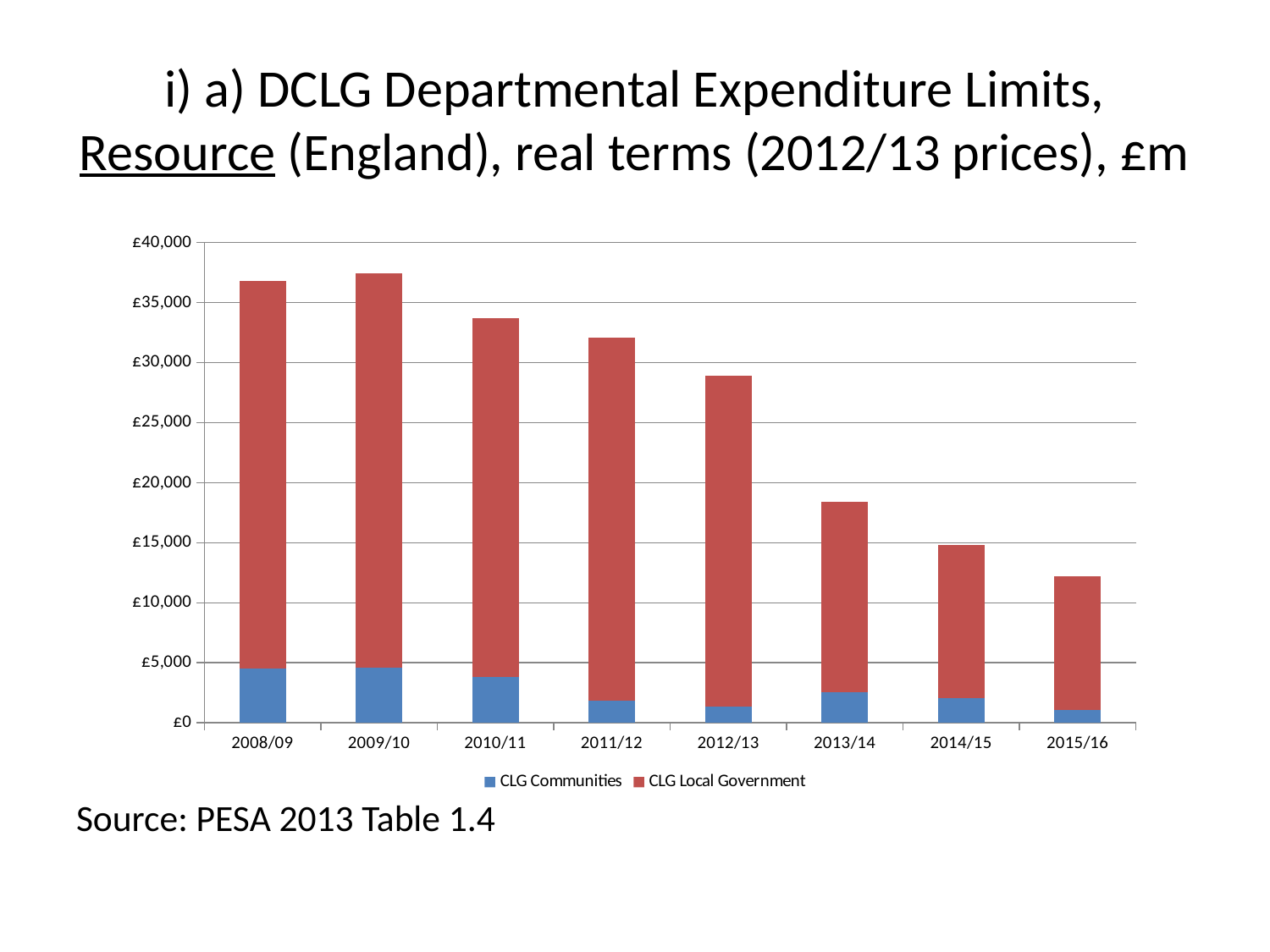
Is the total bar for 2012/13 greater or less than £25,000? greater Do the total bar heights generally rise or fall from 2009/10 to 2015/16? Fall Which series is shown in red in the chart? CLG Local Government Is the total bar for 2013/14 greater or less than £20,000? less How many years are shown on the x axis of the chart? 8 What source is cited below the chart? PESA 2013 Table 1.4 What kind of chart is shown on the slide? Stacked bar chart How many series does the chart's legend list? 2 Is the total bar for 2008/09 greater or less than £35,000? greater Which year has the lowest total bar in the chart? 2015/16 Which year has the larger total bar, 2010/11 or 2013/14? 2010/11